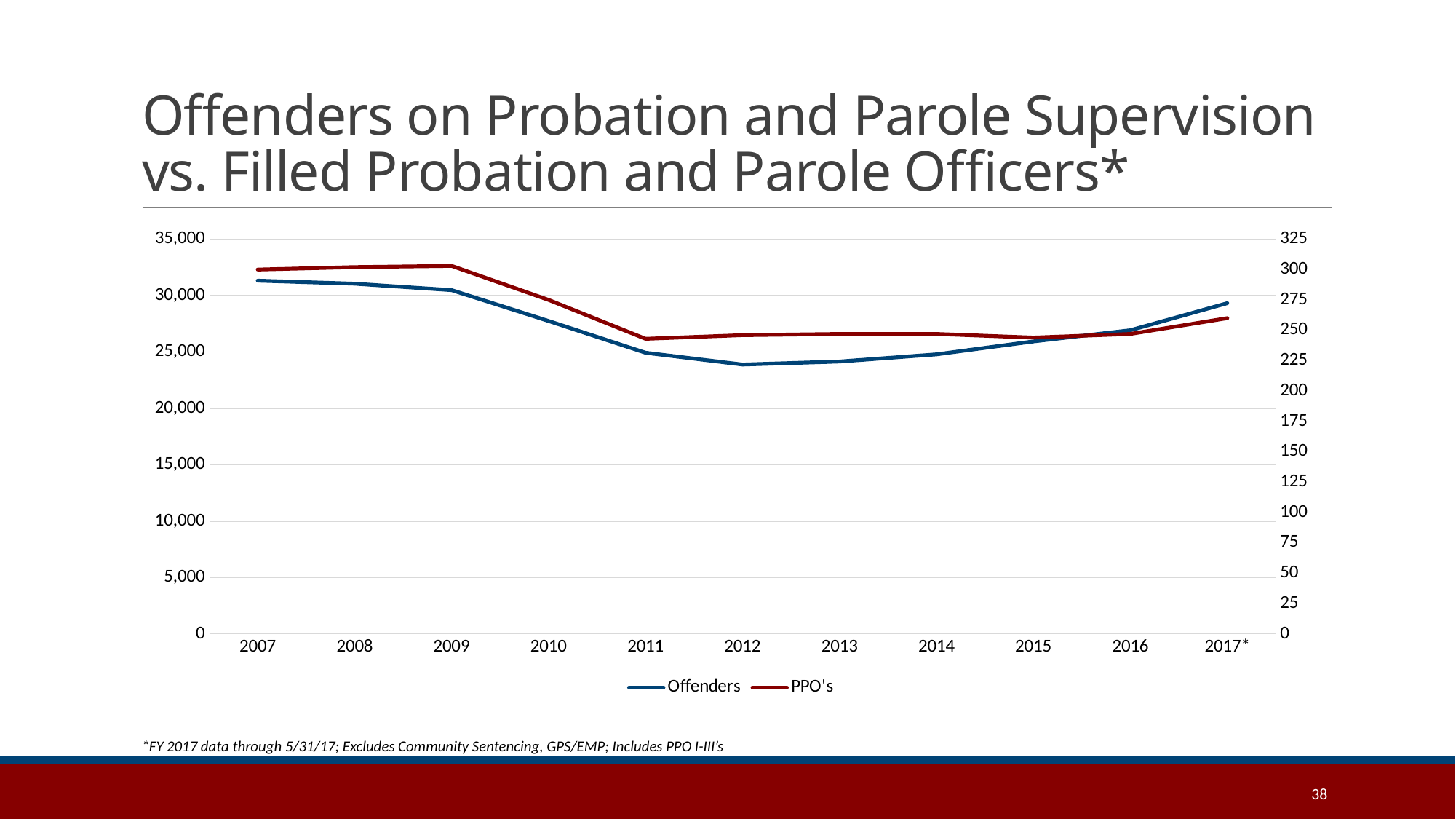
In which year is the Offenders series at its lowest? 2012 Which series is drawn in dark red? PPO's What kind of chart is shown on the slide? Line chart Is the PPO's value for 2007 greater or less than 275? greater Is the Offenders value for 2012 greater or less than 25,000? less Does the Offenders series rise or fall from 2009 to 2012? Fall How many series does the legend list? 2 What are the two series named in the legend? Offenders and PPO's Is the Offenders value for 2007 greater or less than 30,000? greater How many years are plotted along the x axis? 11